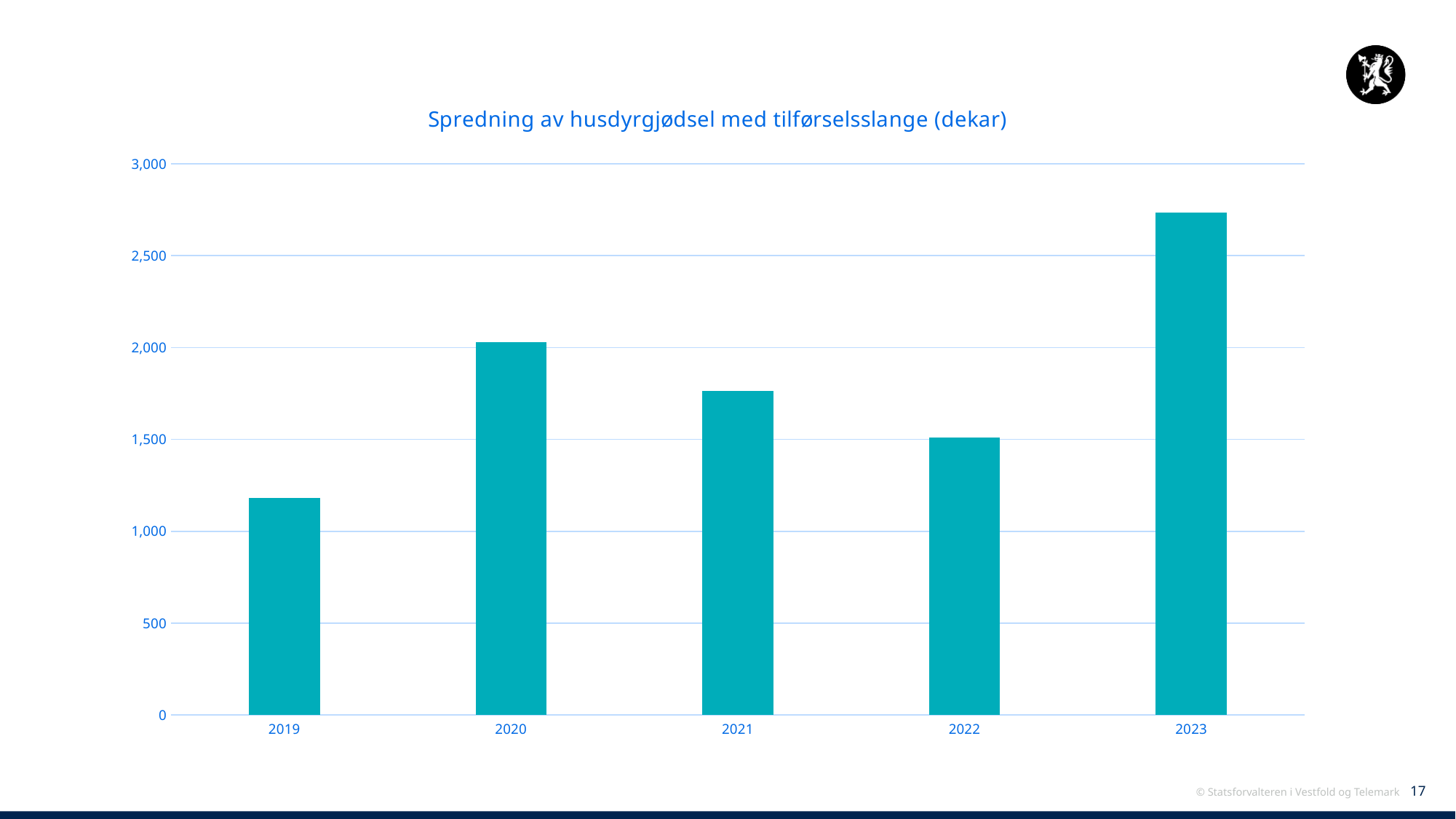
Is the value for 2021 greater or less than 2,000? less Is the value for 2023 greater or less than 2,500? greater Do the values rise or fall from 2020 to 2022? fall How many years are shown on the x axis of the chart? 5 Is the value for 2019 greater or less than 1,500? less Which year has the larger value, 2020 or 2021? 2020 Which year has the highest value in the chart? 2023 Which year has the larger value, 2022 or 2023? 2023 Which year has the lowest value in the chart? 2019 What is the title of the chart? Spredning av husdyrgjødsel med tilførselsslange (dekar) What type of chart is shown on the slide? bar chart